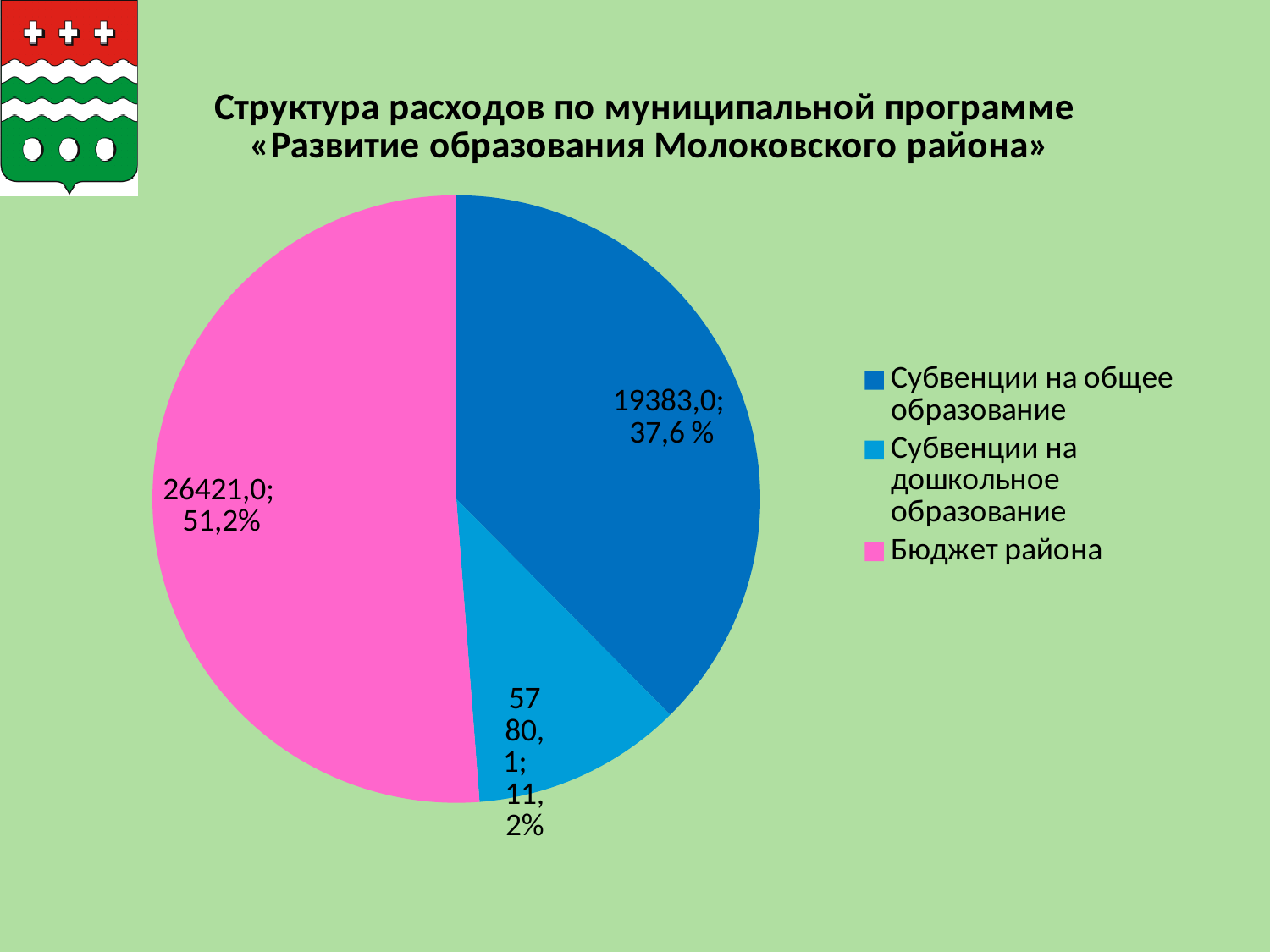
How many slices does the pie chart have? 3 What value is shown for the slice "Субвенции на дошкольное образование"? 5780,1 Which slice of the pie chart is the smallest? Субвенции на дошкольное образование What kind of chart is shown on the slide? pie chart What share of the pie does "Бюджет района" represent? 51,2% What value is shown for the slice "Бюджет района"? 26421,0 Which slice of the pie chart is the largest? Бюджет района What value is shown for the slice "Субвенции на общее образование"? 19383,0 What share of the pie does "Субвенции на общее образование" represent? 37,6 % What is the difference between the values for "Бюджет района" and "Субвенции на общее образование"? 7038,0 What share of the pie does "Субвенции на дошкольное образование" represent? 11,2% Which is larger: "Субвенции на общее образование" or "Субвенции на дошкольное образование"? Субвенции на общее образование